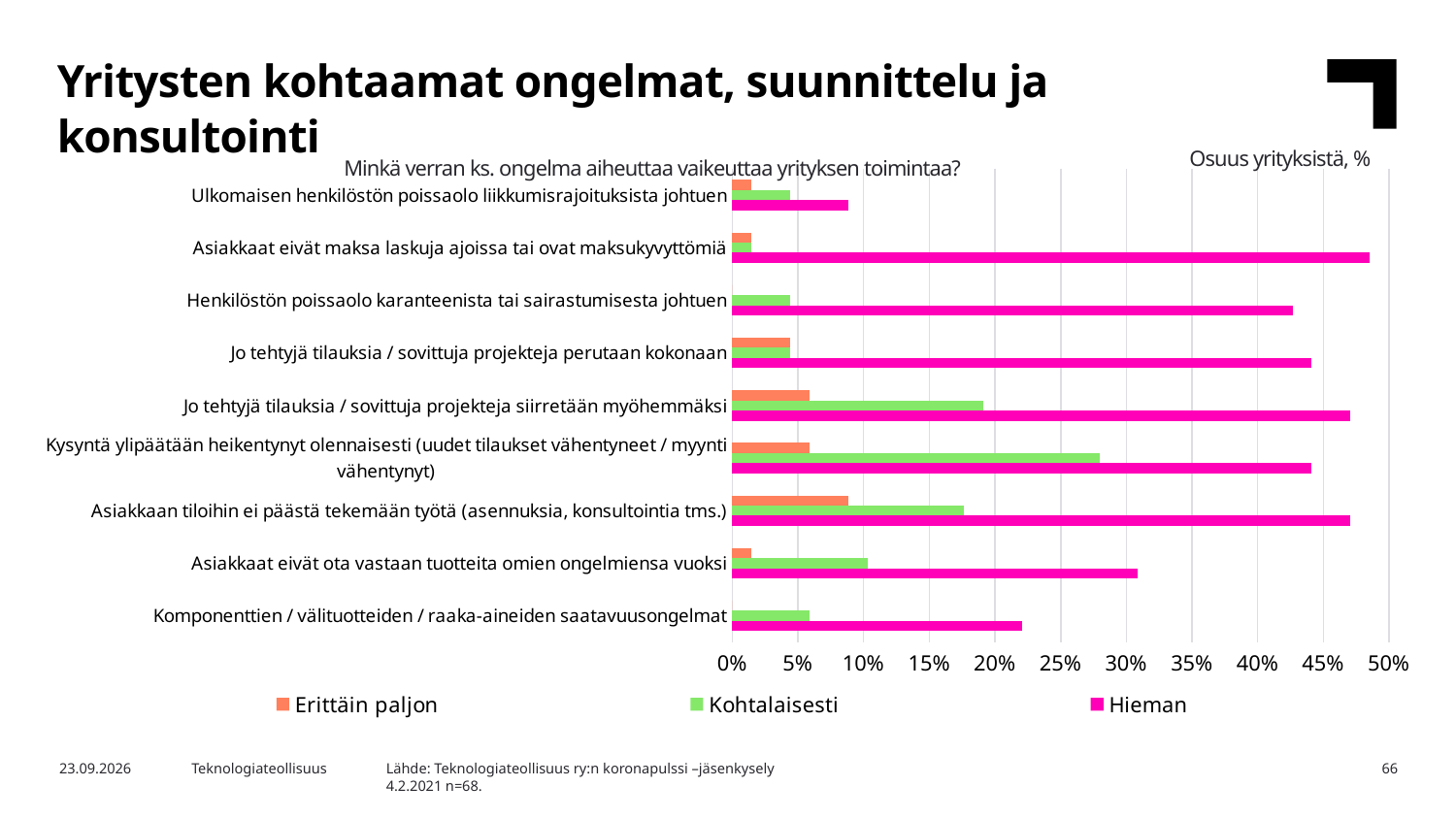
Which category has the highest value for the Kohtalaisesti series? Kysyntä ylipäätään heikentynyt olennaisesti (uudet tilaukset vähentyneet / myynti vähentynyt) What kind of chart is shown on the slide? Bar chart Which category has the lowest value for the Hieman series? Ulkomaisen henkilöstön poissaolo liikkumisrajoituksista johtuen How many series does the legend list? 3 What is the title of the chart? Minkä verran ks. ongelma aiheuttaa vaikeuttaa yrityksen toimintaa? Is the Hieman value for Asiakkaat eivät ota vastaan tuotteita omien ongelmiensa vuoksi greater or less than 25%? greater Is the Hieman value for Komponenttien / välituotteiden / raaka-aineiden saatavuusongelmat greater or less than 20%? greater Which colour represents the Hieman series in the chart? Magenta (pink) How many problem categories are plotted on the chart? 9 Is the Hieman value for Henkilöstön poissaolo karanteenista tai sairastumisesta johtuen greater or less than 45%? less For the Erittäin paljon series, which is larger: Asiakkaan tiloihin ei päästä tekemään työtä or Kysyntä ylipäätään heikentynyt olennaisesti? Asiakkaan tiloihin ei päästä tekemään työtä (asennuksia, konsultointia tms.)